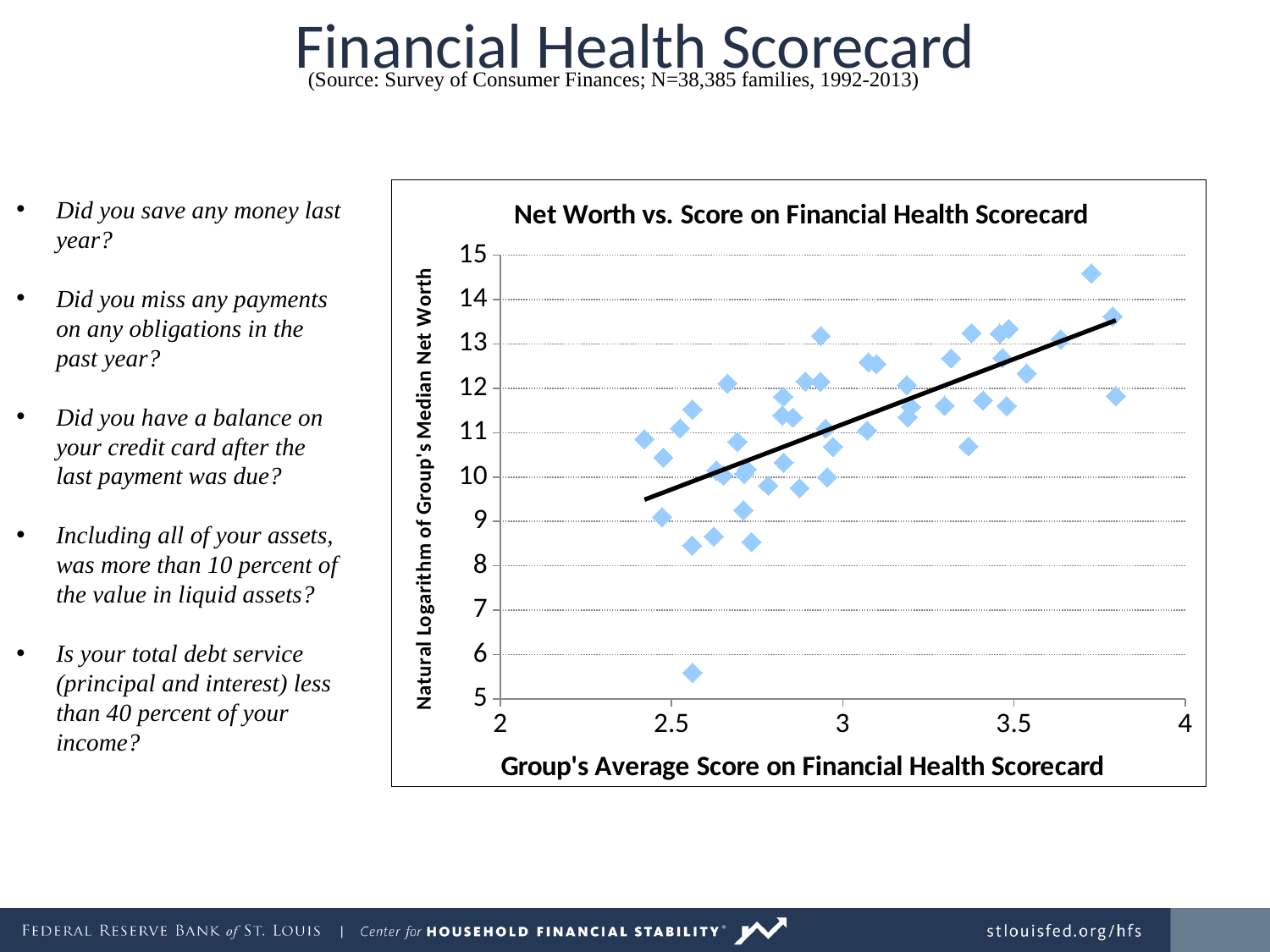
Is the lowest plotted point in the chart located at an x value greater or less than 3? less What is the label of the x axis of the chart? Group's Average Score on Financial Health Scorecard What is the title of the chart? Net Worth vs. Score on Financial Health Scorecard Do the plotted net worth values generally rise or fall as the group's average score increases along the x axis? Rise Is the highest plotted point in the chart located at an x value greater or less than 3.5? greater Is the highest plotted point in the chart greater or less than 14 on the y axis? greater What kind of chart is shown on the slide? Scatter chart Does the trend line in the chart slope upward or downward from left to right? Upward